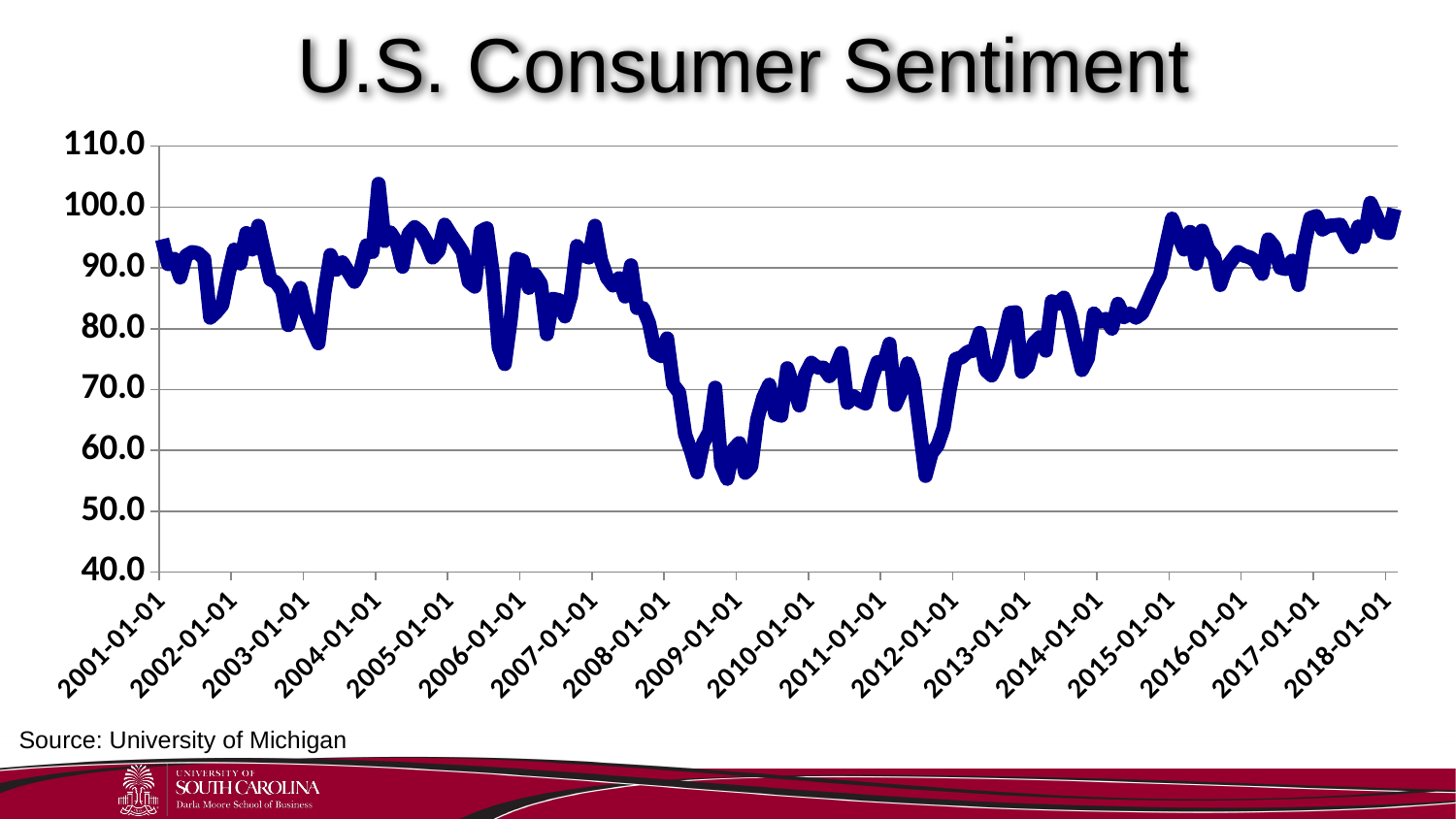
Is the value at 2018-01-01 greater or less than 90? greater Is the value at 2001-01-01 greater or less than 80? greater Is the value at 2010-01-01 greater or less than 80? less What source is cited for the chart data? University of Michigan Does consumer sentiment rise or fall between 2008-01-01 and 2009-01-01? fall How many lines are plotted on the chart? 1 What is the title of the chart? U.S. Consumer Sentiment How many date labels are shown on the x axis? 18 What kind of chart is shown on the slide? line chart